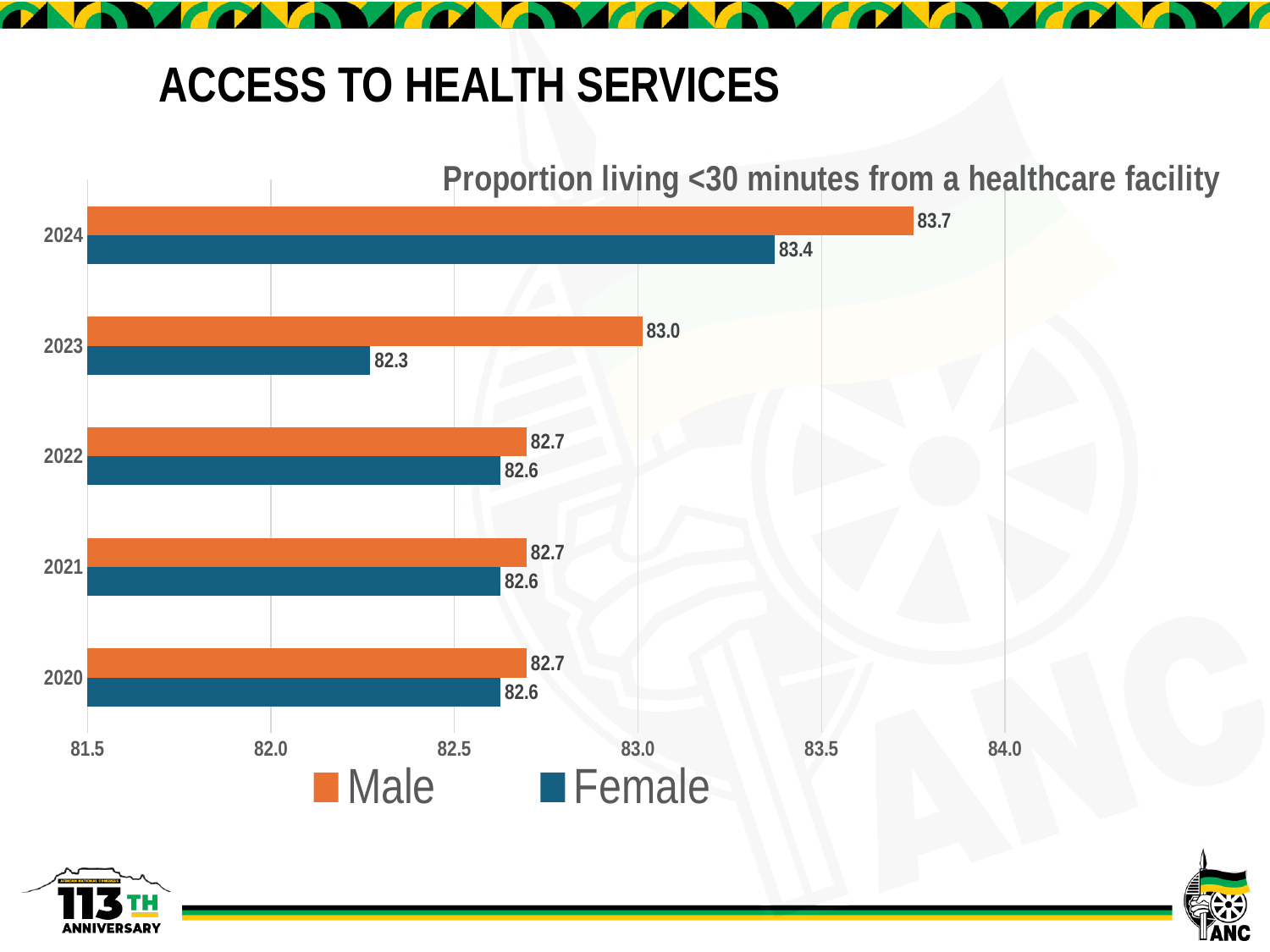
Which is larger in 2024, the Male value or the Female value? Male What is the title of the chart? Proportion living <30 minutes from a healthcare facility What kind of chart is shown on the slide? Bar chart How many series does the legend list? 2 How many years are shown on the chart? 5 What is the Female value for 2023? 82.3 What is the Female value for 2020? 82.6 What is the difference between the Male and Female values for 2023? 0.7 Which year has the lowest Female value? 2023 What is the Male value for 2024? 83.7 Which year has the highest Female value? 2024 What is the difference between the Male values for 2024 and 2023? 0.7